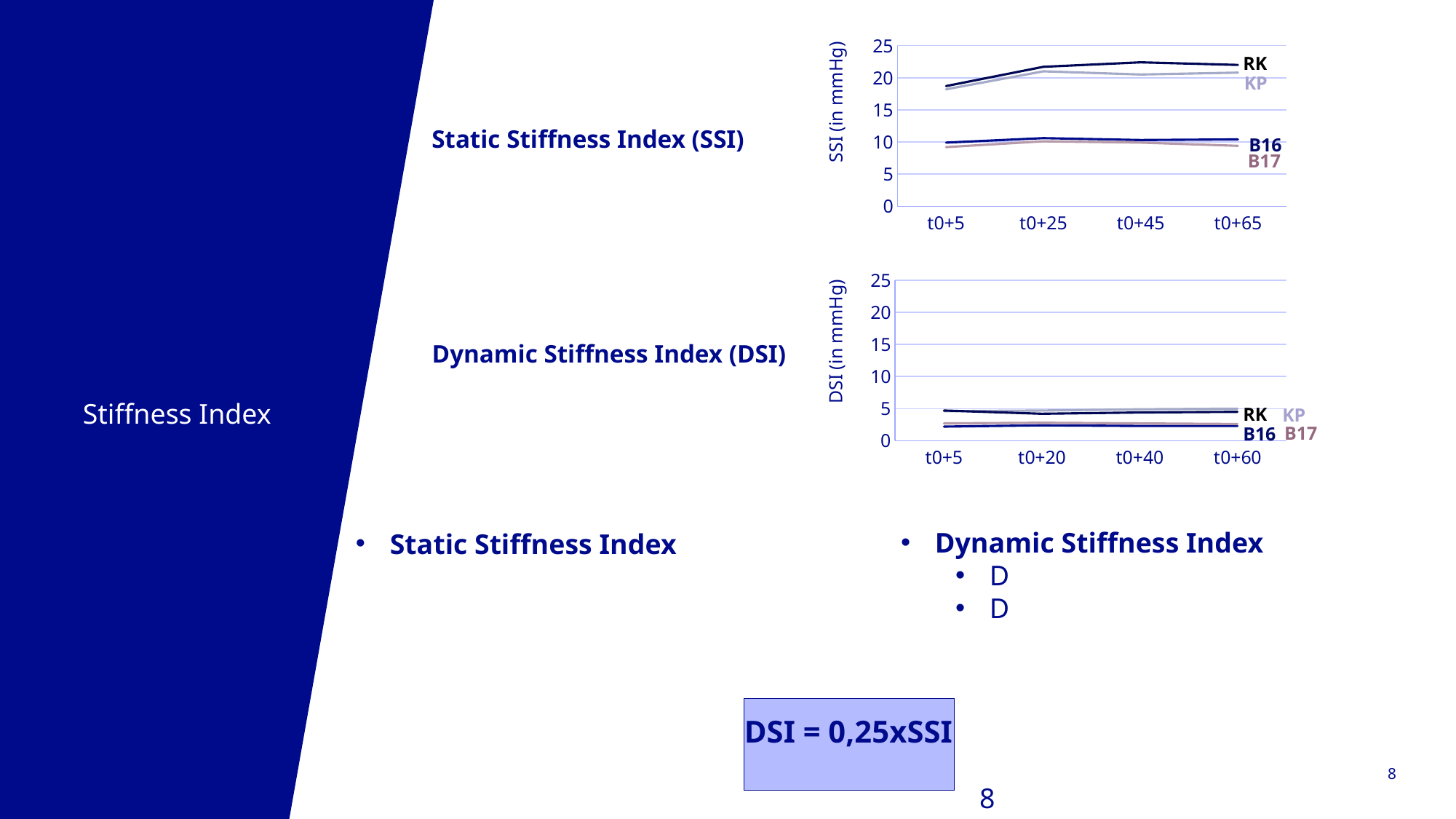
How many time points are shown on the x axis of the Static Stiffness Index (SSI) chart? 4 In the Dynamic Stiffness Index (DSI) chart, is the value for B16 at t0+40 greater or less than 5? less In the Static Stiffness Index (SSI) chart, is the value for B16 at t0+25 greater or less than 15? less How many series are labelled on the Dynamic Stiffness Index (DSI) chart? 4 In the Static Stiffness Index (SSI) chart, which is larger at t0+65, RK or B16? RK What is the last x-axis label on the Dynamic Stiffness Index (DSI) chart? t0+60 In the Static Stiffness Index (SSI) chart, does the RK series rise or fall from t0+5 to t0+45? rise What is the y-axis label of the Dynamic Stiffness Index (DSI) chart? DSI (in mmHg) In the Dynamic Stiffness Index (DSI) chart, is the value for RK at t0+5 greater or less than 10? less In the Static Stiffness Index (SSI) chart, which series has the highest values? RK What kind of chart is the Static Stiffness Index (SSI) chart? line chart